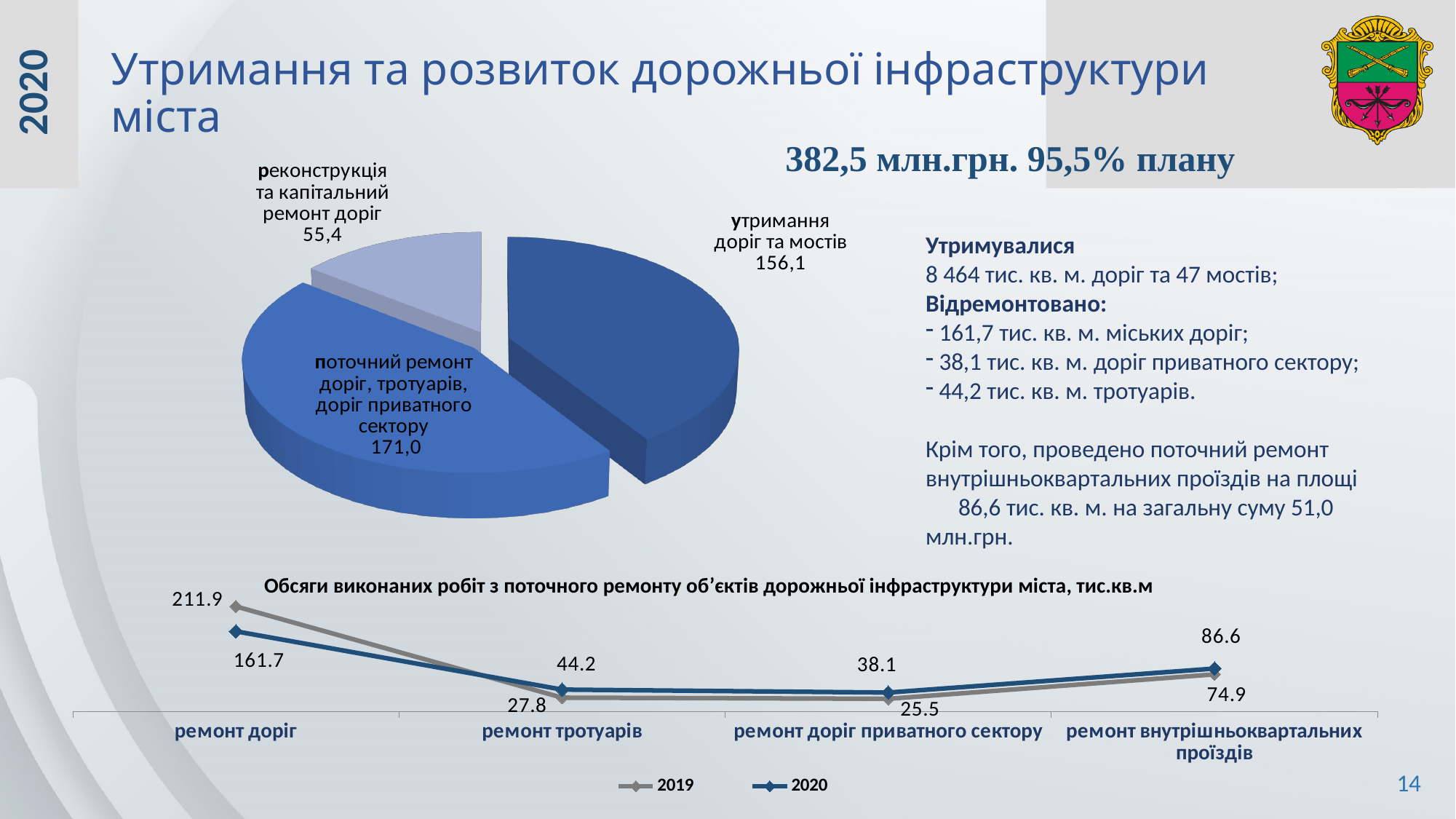
In the pie chart, how many slices are there? 3 In the pie chart, what is the difference between the values for поточний ремонт доріг, тротуарів, доріг приватного сектору and реконструкція та капітальний ремонт доріг? 115,6 What type of chart is shown at the bottom of the slide? line chart In the line chart at the bottom of the slide, how many series does the legend list? 2 In the line chart at the bottom of the slide, what is the 2020 value for ремонт тротуарів? 44.2 In the pie chart, which category has the smallest slice? реконструкція та капітальний ремонт доріг In the line chart at the bottom of the slide, what is the difference between the 2019 and 2020 values for ремонт доріг? 50.2 In the line chart at the bottom of the slide, what is the 2019 value for ремонт доріг? 211.9 In the line chart at the bottom of the slide, which is larger for ремонт доріг приватного сектору: the 2019 value or the 2020 value? 2020 In the pie chart, which category has the largest slice? поточний ремонт доріг, тротуарів, доріг приватного сектору In the pie chart, what is the value for утримання доріг та мостів? 156,1 In the pie chart, what share of the total does реконструкція та капітальний ремонт доріг represent? 14.5%